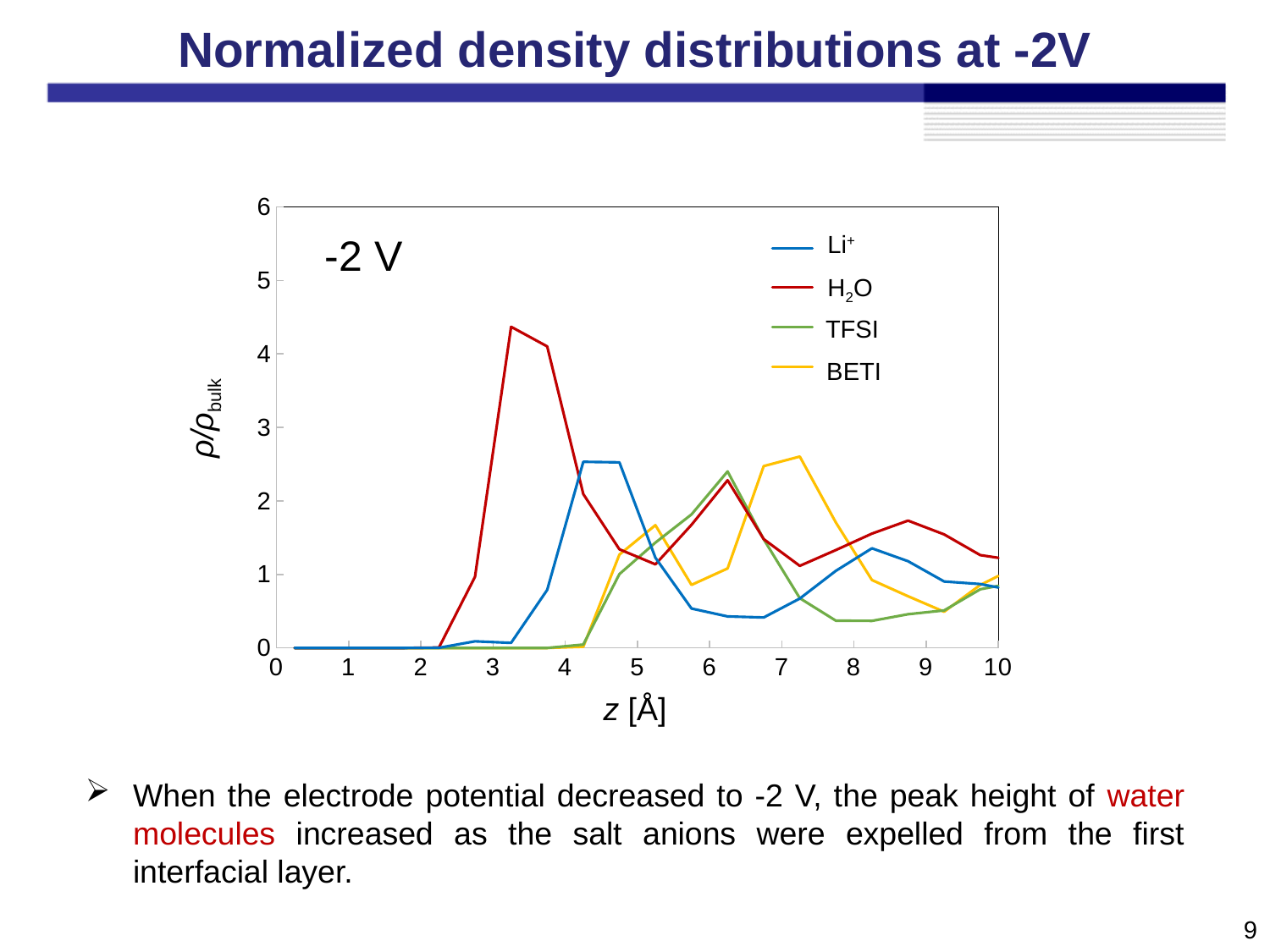
Is the peak value of the BETI curve greater or less than 2? greater Is the peak value of the Li+ curve greater or less than 3? less What is the label of the x axis? z [Å] At z = 3 Å, which is larger: the H2O value or the Li+ value? H2O Is the peak value of the H2O curve greater or less than 4? greater Which series reaches the highest peak value of ρ/ρbulk? H2O What colour is the H2O line in the chart? red Does the H2O curve rise or fall between z = 4 Å and z = 5 Å? fall How many series does the legend list? 4 What kind of chart is shown on the slide? line chart At z = 7 Å, which is larger: the BETI value or the H2O value? BETI